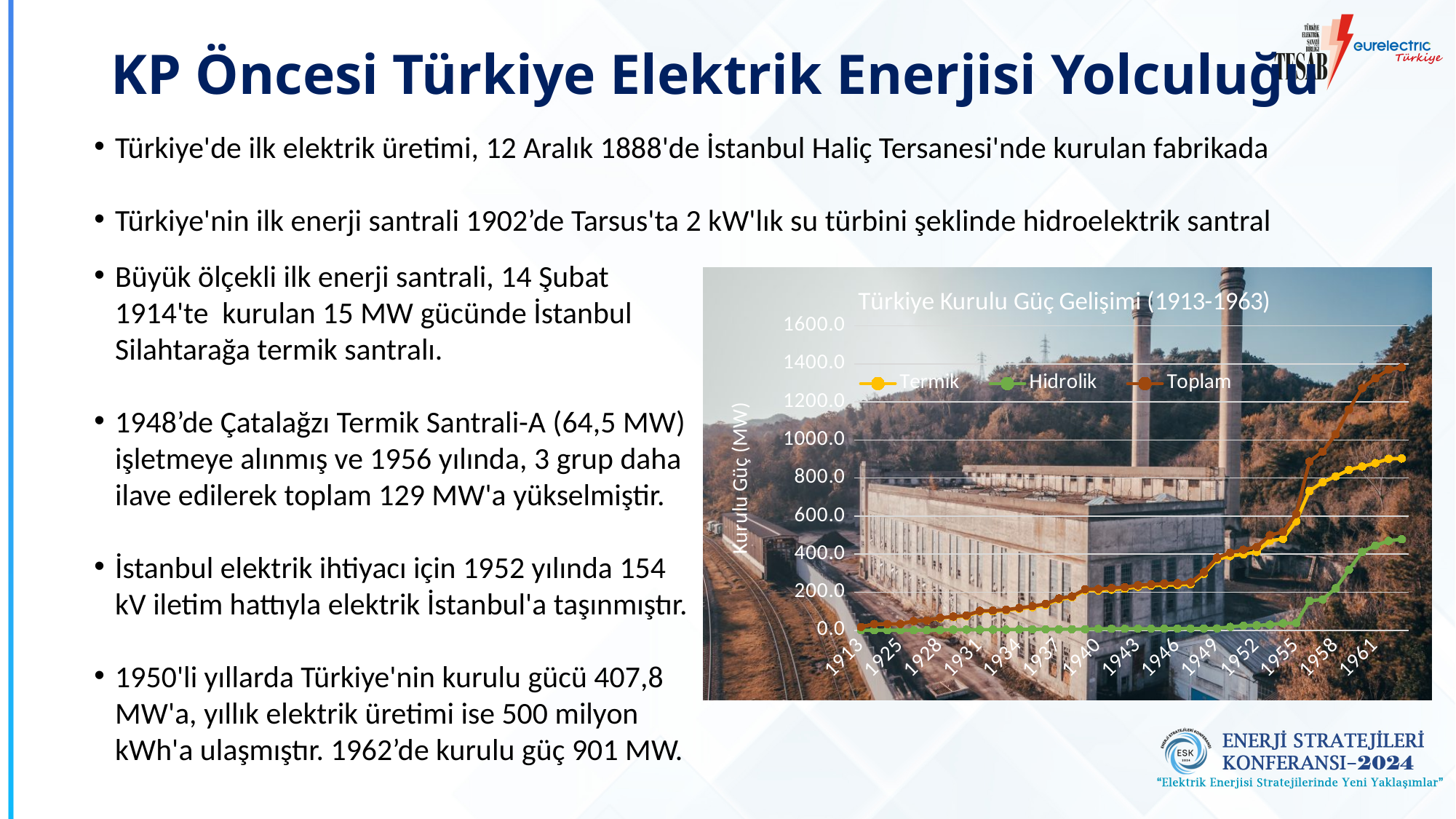
Is the value for Hidrolik at 1961 greater or less than 600? less What is the title of the chart on the slide? Türkiye Kurulu Güç Gelişimi (1913-1963) What is the highest tick value shown on the chart's y axis? 1600.0 How many series does the chart's legend list? 3 At 1961, which is larger in the chart: Termik or Hidrolik? Termik Is the value for Toplam at 1940 greater or less than 400? less Which series in the chart has the lowest value at 1961? Hidrolik Is the value for Toplam at 1961 greater or less than 1200? greater What are the series names listed in the chart's legend? Termik, Hidrolik, Toplam Which series in the chart has the highest value at 1961? Toplam Does the Toplam series rise or fall from 1913 to 1961? rise What kind of chart is shown on the slide? line chart